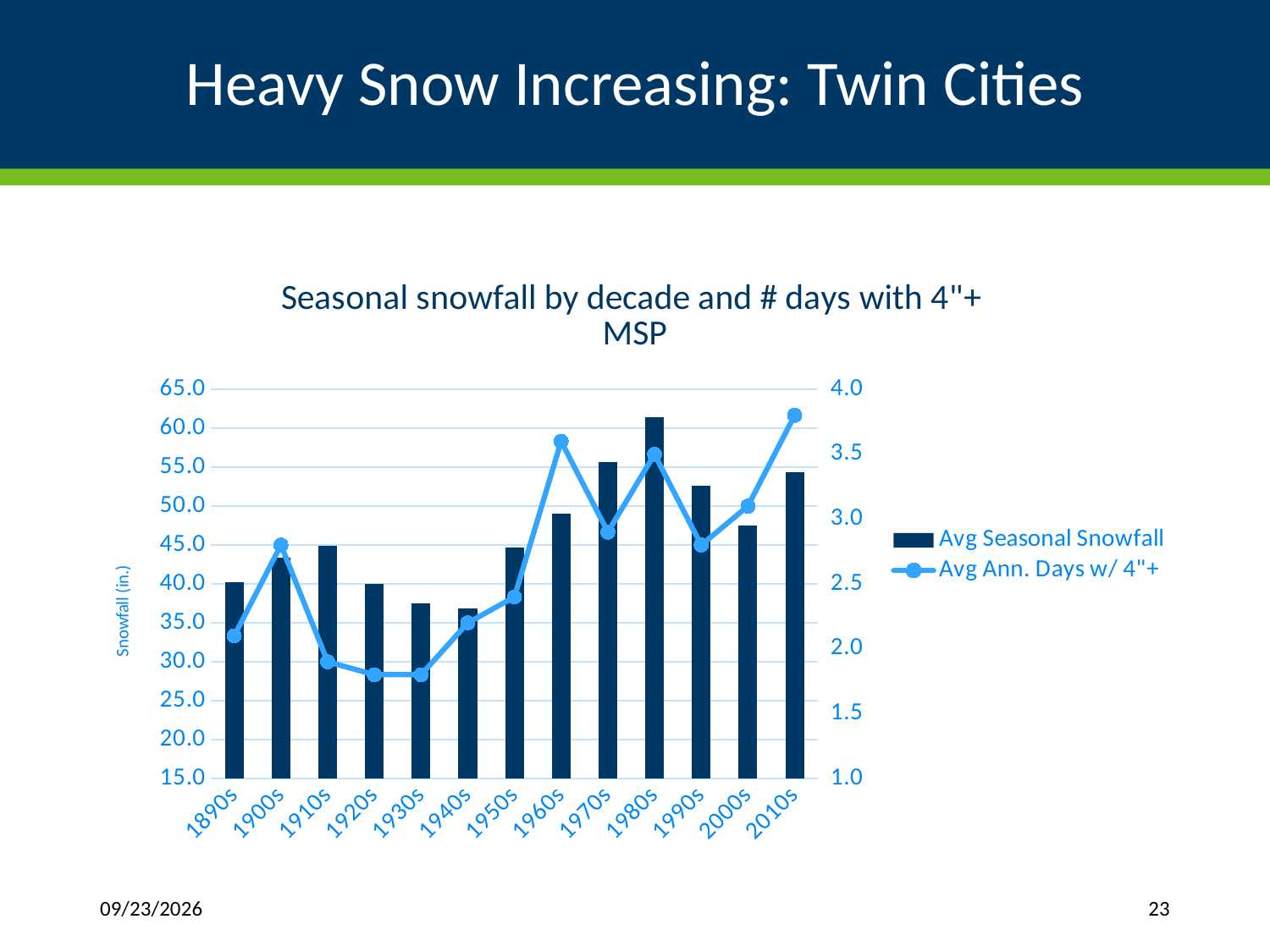
Which decade has the larger Avg Seasonal Snowfall, the 1970s or the 1980s? 1980s How many series does the legend list? 2 Is the Avg Ann. Days w/ 4"+ value for the 2010s greater or less than 3.5? greater Which decade has the highest Avg Seasonal Snowfall bar? 1980s How many decades are shown on the x axis? 13 Is the Avg Seasonal Snowfall for the 1890s greater or less than 45.0? less Which decade has more Avg Ann. Days w/ 4"+, the 1960s or the 1970s? 1960s Is the Avg Seasonal Snowfall for the 1980s greater or less than 60.0? greater What kind of chart is shown on the slide? A combined bar and line chart Which decade has the highest value for Avg Ann. Days w/ 4"+? 2010s What is the label on the left vertical axis? Snowfall (in.)